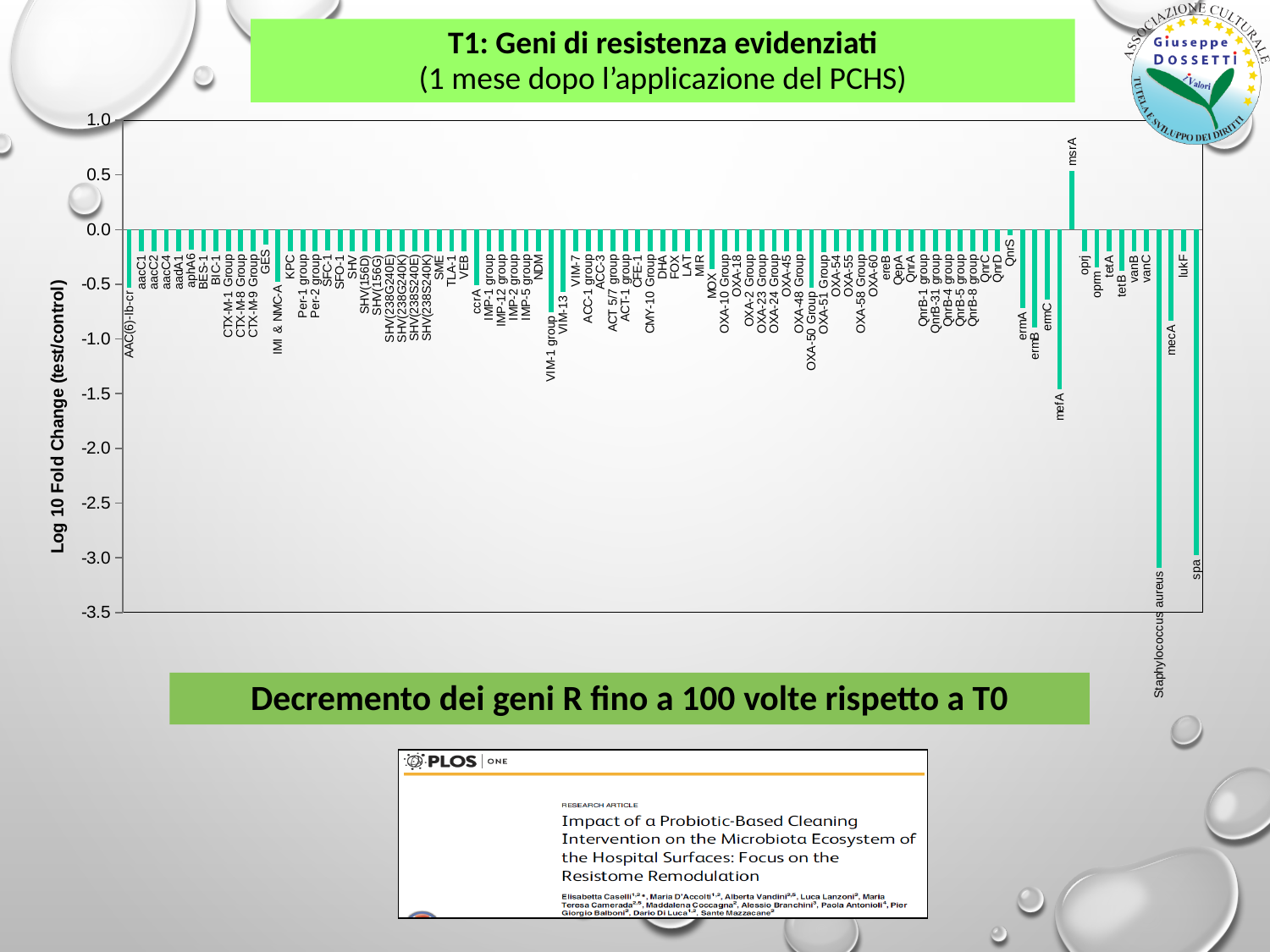
Is the value for spa greater or less than -2.0? less Is the value for mefA greater or less than -1.0? less Which has the larger Log 10 Fold Change value, msrA or mefA? msrA Is the value for mecA greater or less than -0.5? less What is the label of the vertical axis of the chart? Log 10 Fold Change (test/control) What is the title shown above the chart? T1: Geni di resistenza evidenziati (1 mese dopo l'applicazione del PCHS) Which gene has the highest Log 10 Fold Change value in the chart? msrA What kind of chart is shown on the slide? bar chart Which has the larger Log 10 Fold Change value, KPC or spa? KPC